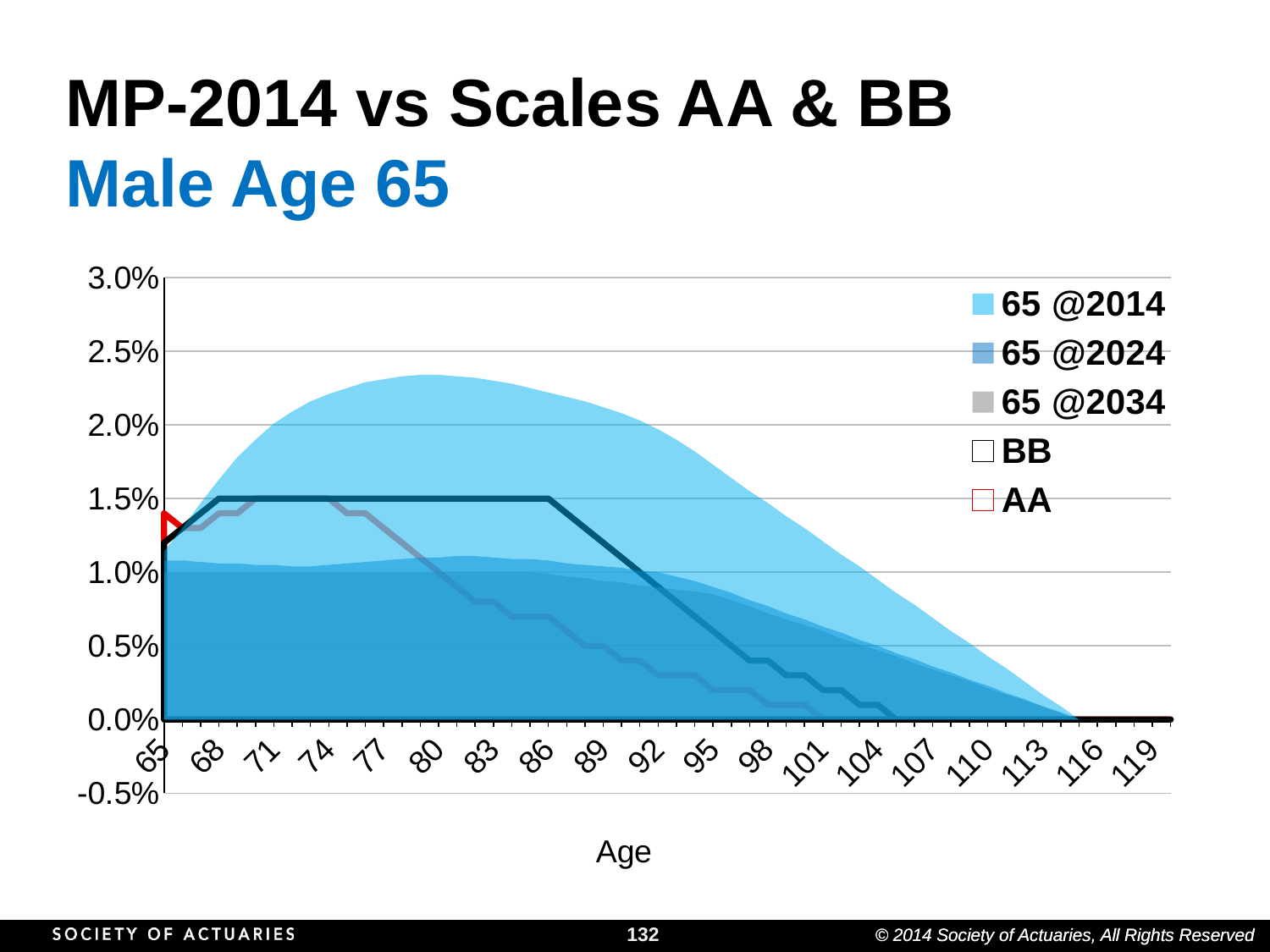
Is the value of the 65 @2014 series at age 80 greater or less than 2.0%? greater Is the value of the 65 @2014 series at age 113 greater or less than 0.5%? less Is the value of the 65 @2024 series at age 95 greater or less than 1.0%? less Which series is drawn in red in the legend? AA Which series has the highest value at age 80? 65 @2014 Does the 65 @2014 series rise or fall between age 92 and age 116? fall At age 80, which is larger: the BB series or the 65 @2024 series? BB At age 110, which is larger: the 65 @2014 series or the BB series? 65 @2014 How many series does the legend list? 5 What is the title of the x axis? Age What kind of chart is shown on the slide? area chart